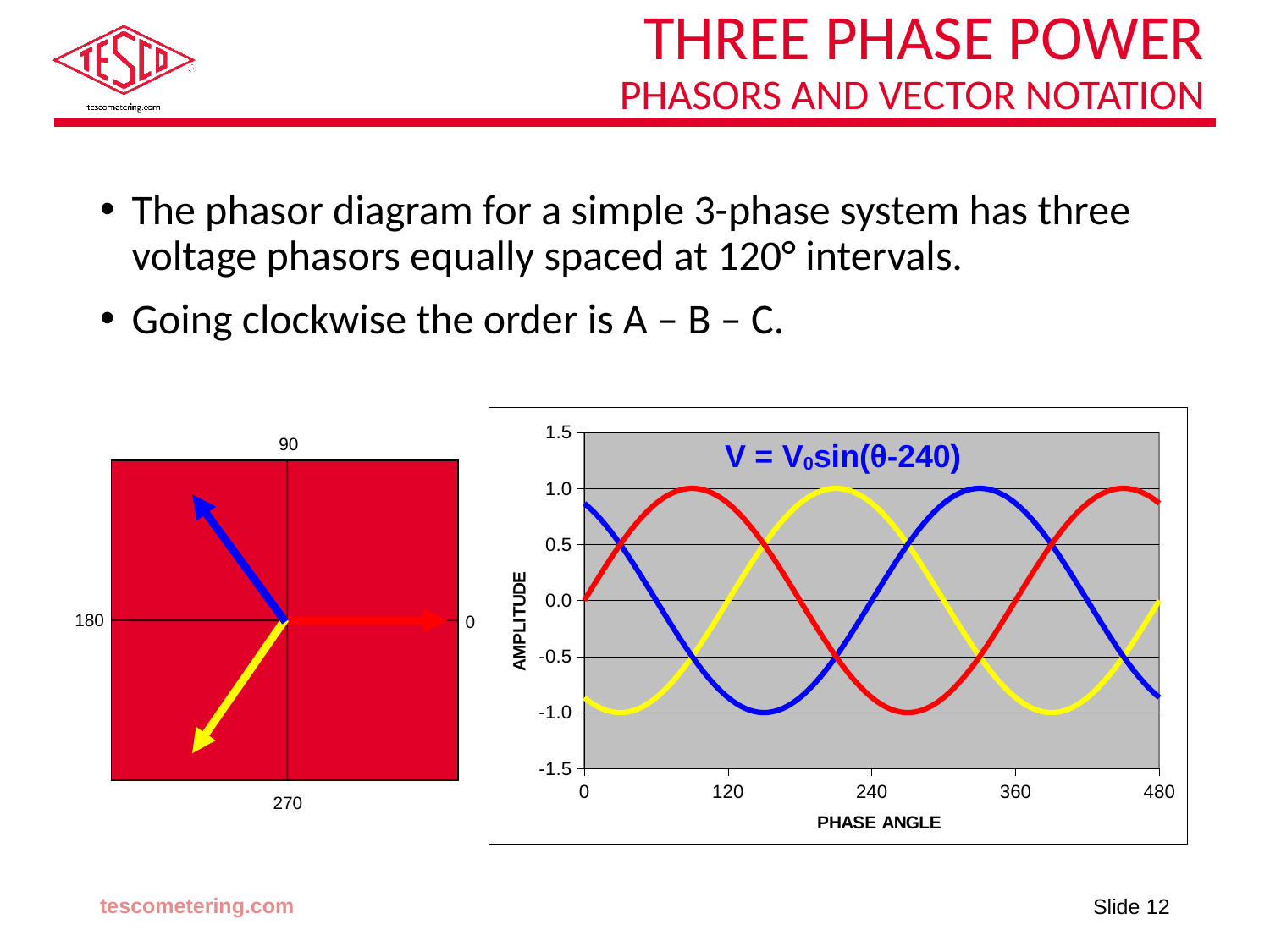
In the chart on the right, at phase angle 240, which line has the larger amplitude, the red line or the blue line? blue In the chart on the right, what is the amplitude of the red line at phase angle 0? 0.0 In the chart on the right, how many lines are plotted? 3 In the chart on the right, what is the highest value shown on the vertical axis? 1.5 In the chart on the right, is the amplitude of the red line at phase angle 120 greater or less than 0.5? greater In the phasor diagram on the left, how many phasor arrows are drawn? 3 What kind of chart is the chart on the right of the slide? line chart In the chart on the right, is the amplitude of the blue line at phase angle 240 greater or less than 0.5? less In the chart on the right, what is the title of the horizontal axis? PHASE ANGLE In the chart on the right, what is the largest phase angle shown on the horizontal axis? 480 In the chart on the right, is the amplitude of the yellow line at phase angle 120 greater or less than -0.5? greater In the chart on the right, what is the title of the vertical axis? AMPLITUDE